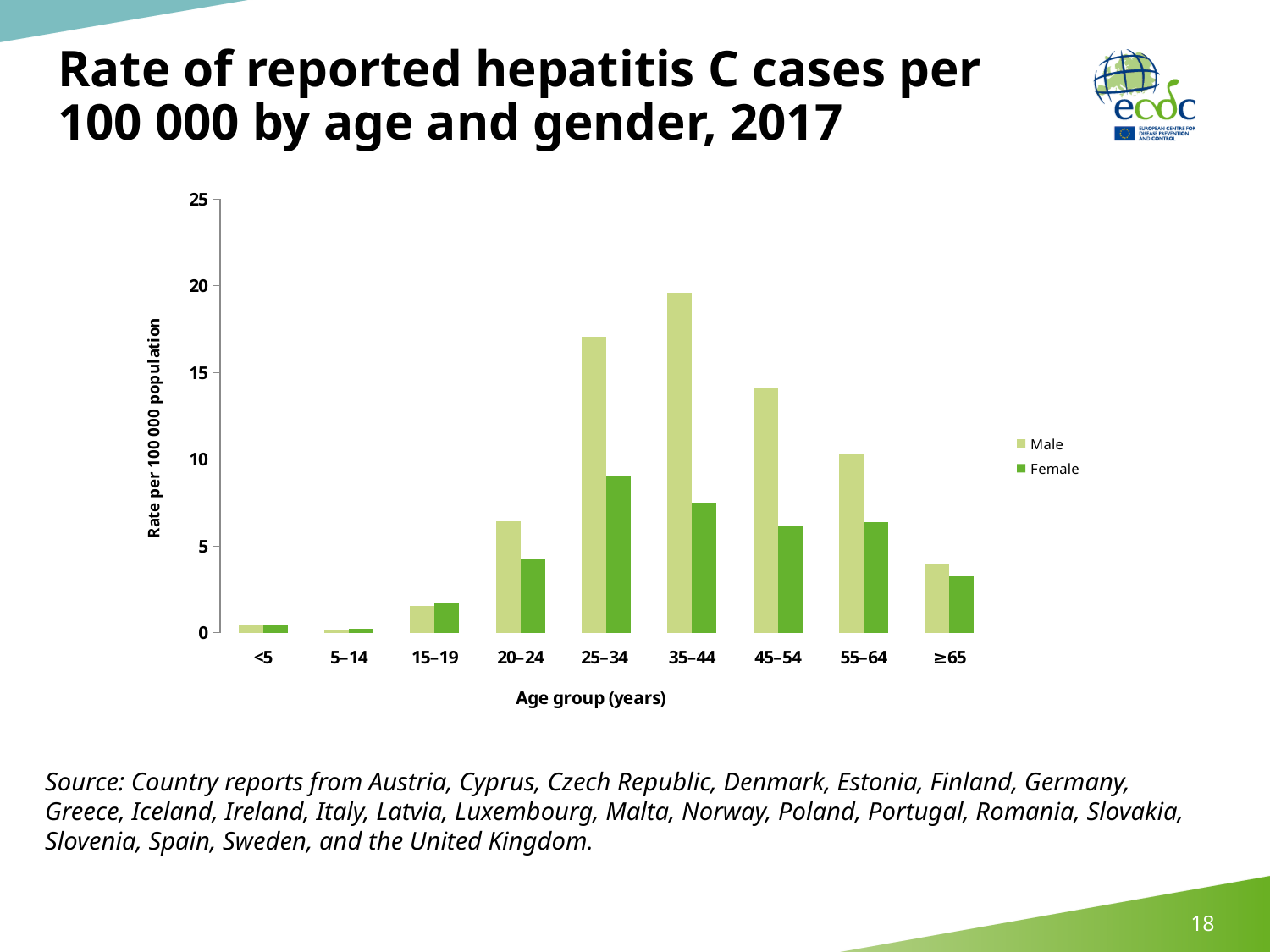
Which is larger, the male rate for 25–34 or the male rate for 45–54? 25–34 Do the male rates rise or fall from the 35–44 age group to the ≥65 age group? fall What is the title of the y axis? Rate per 100 000 population Which age group has the lowest rate for males? 5–14 Is the male rate for the 35–44 age group greater or less than 15? greater Is the female rate for the 25–34 age group greater or less than 10? less Is the male rate for the 45–54 age group greater or less than 15? less How many age groups are shown on the x axis? 9 What kind of chart is shown on the slide? Bar chart How many series does the legend list? 2 Which age group has the highest rate for females? 25–34 Which age group has the highest rate for males? 35–44